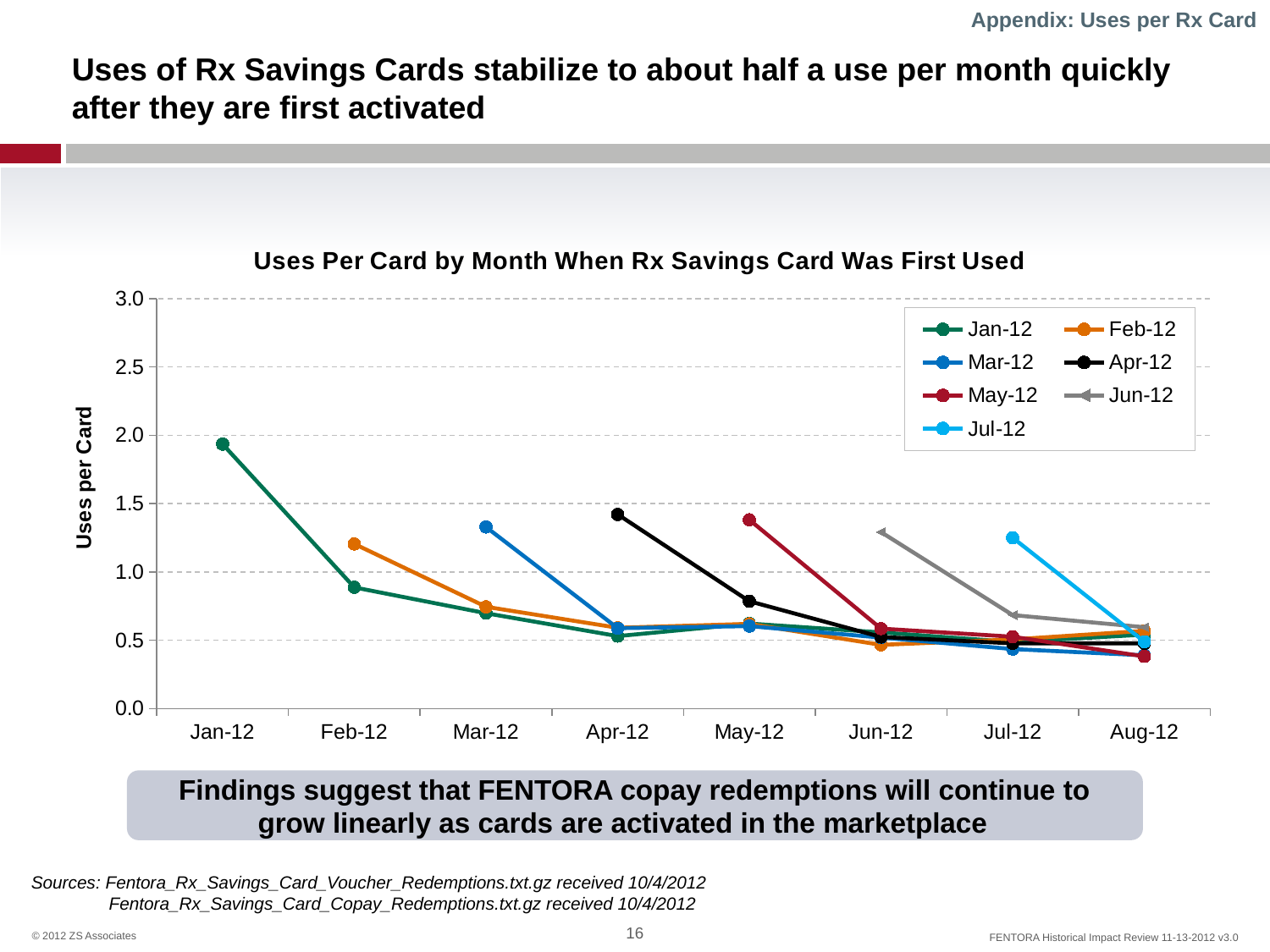
How many series does the legend list? 7 Is the value for the Mar-12 series at Mar-12 greater or less than 1.0? greater Is the value for the Jan-12 series at Feb-12 greater or less than 1.0? less What is the title of the chart? Uses Per Card by Month When Rx Savings Card Was First Used Does the Jan-12 series rise or fall from Jan-12 to Feb-12? fall What is the label on the y axis? Uses per Card Is the value for the Feb-12 series at Feb-12 greater or less than 1.0? greater Which series has the highest value anywhere on the chart? Jan-12 What kind of chart is shown on the slide? line chart How many months are shown along the x axis? 8